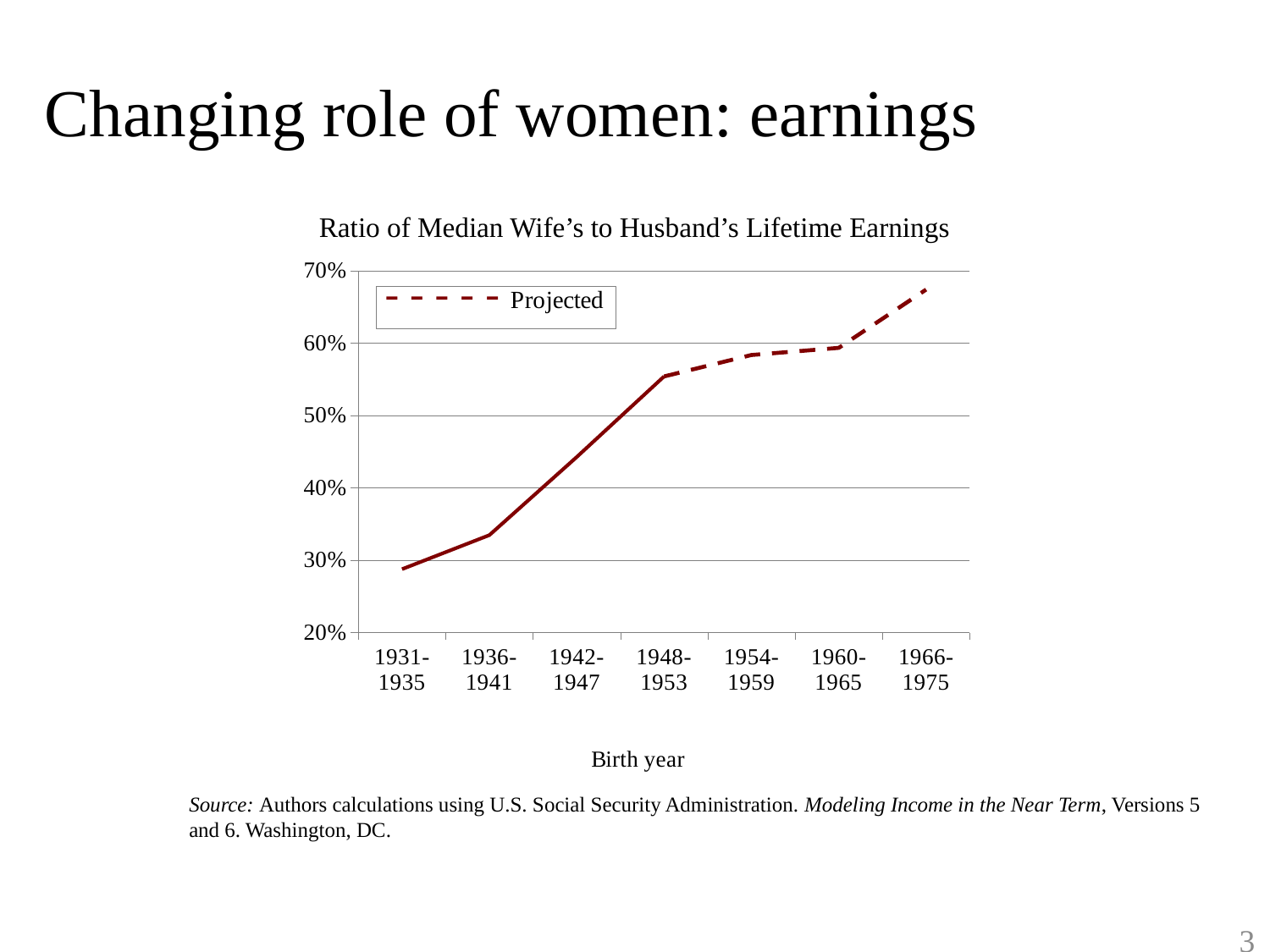
Is the value for 1942-1947 greater or less than 40%? greater Which birth-year group has the highest ratio? 1966-1975 Is the value for 1948-1953 greater or less than 50%? greater What is the title of the chart? Ratio of Median Wife's to Husband's Lifetime Earnings What kind of chart is shown on the slide? line chart Which birth-year group has the lowest ratio? 1931-1935 How many birth-year categories are shown on the x axis? 7 Is the value for 1931-1935 greater or less than 30%? less What is the label of the x axis? Birth year Which is larger, the value for 1936-1941 or the value for 1948-1953? 1948-1953 Do the values rise or fall as birth year increases along the x axis? rise